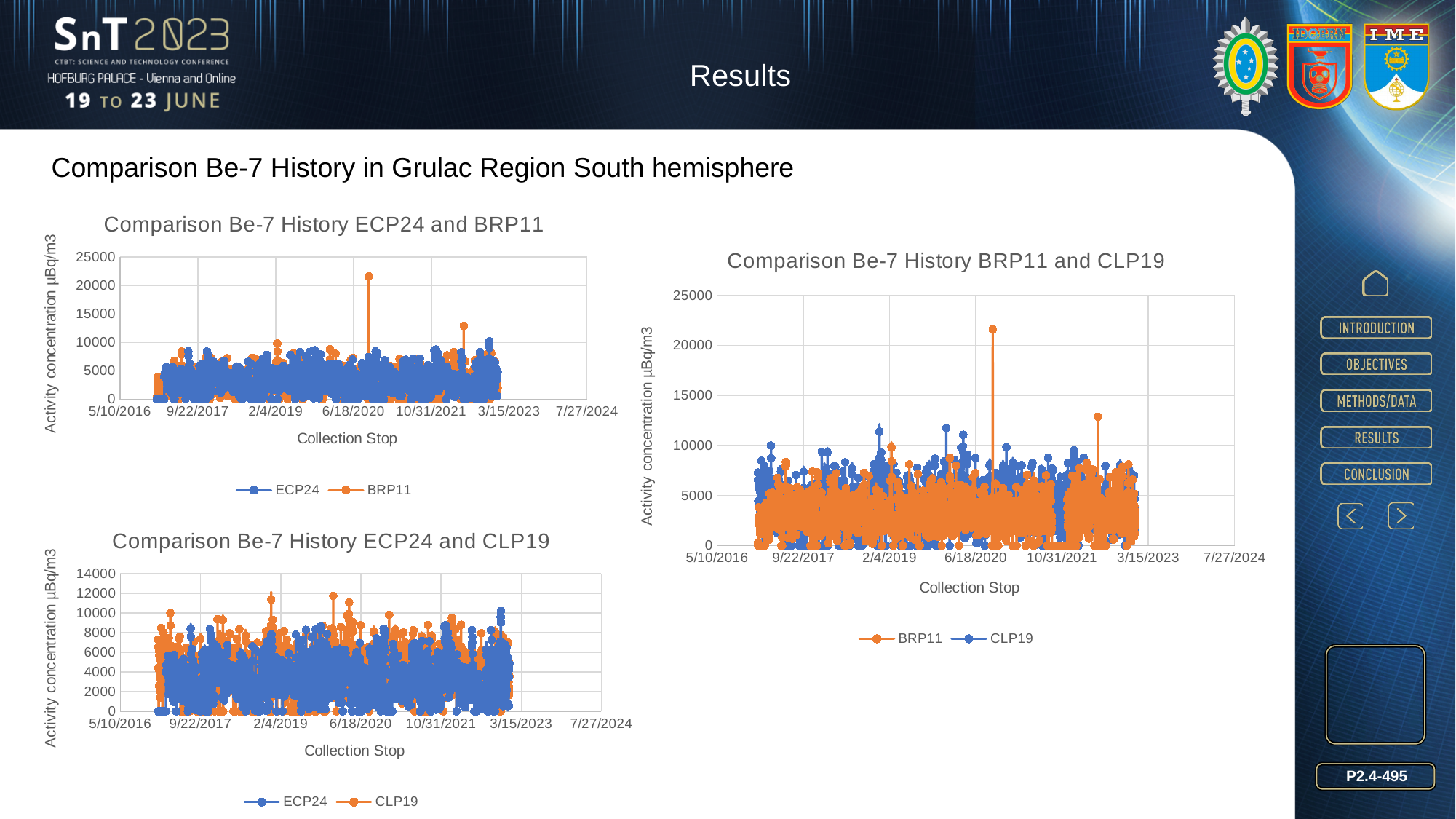
In the chart titled "Comparison Be-7 History ECP24 and CLP19", is the highest CLP19 value greater or less than 10000? greater What is the maximum value shown on the y-axis of the chart titled "Comparison Be-7 History ECP24 and BRP11"? 25000 What kind of chart is the chart titled "Comparison Be-7 History ECP24 and CLP19"? line chart What is the x-axis label of the chart titled "Comparison Be-7 History BRP11 and CLP19"? Collection Stop In the chart titled "Comparison Be-7 History ECP24 and BRP11", which series does the legend list first? ECP24 What is the maximum value shown on the y-axis of the chart titled "Comparison Be-7 History ECP24 and CLP19"? 14000 In the chart titled "Comparison Be-7 History BRP11 and CLP19", is the highest BRP11 value greater or less than 20000? greater In the chart titled "Comparison Be-7 History BRP11 and CLP19", which two series are listed in the legend? BRP11 and CLP19 In the chart titled "Comparison Be-7 History BRP11 and CLP19", which series reaches the highest single value? BRP11 In the chart titled "Comparison Be-7 History ECP24 and BRP11", is the highest BRP11 spike greater or less than 20000? greater In the chart titled "Comparison Be-7 History ECP24 and BRP11", which series reaches the highest single value? BRP11 How many series does the legend list in the chart titled "Comparison Be-7 History ECP24 and BRP11"? 2